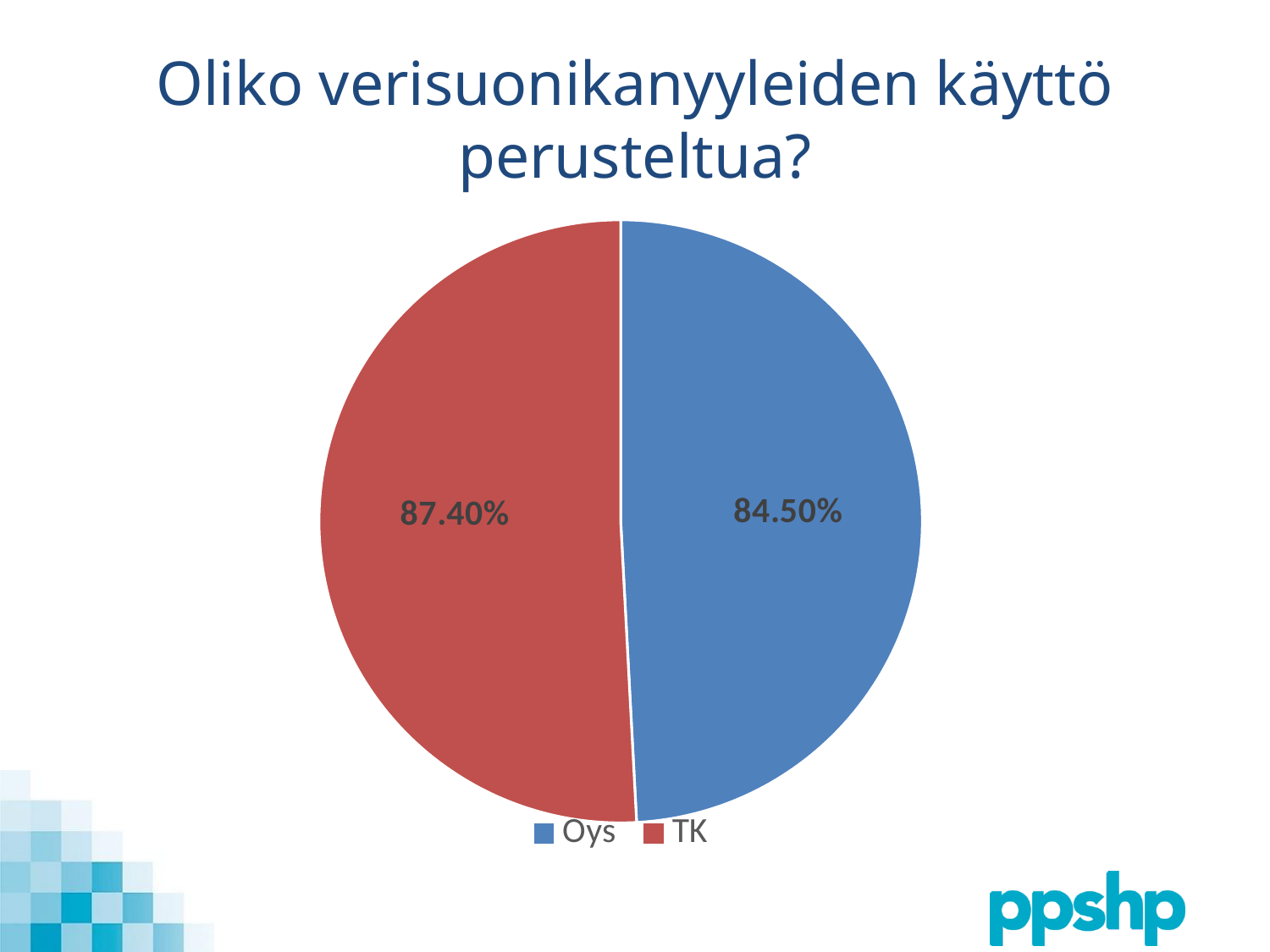
Which category has the highest value in the pie chart? TK What kind of chart is shown on the slide? Pie chart How many entries does the legend list? 2 What is the title of the slide above the chart? Oliko verisuonikanyyleiden käyttö perusteltua? What value is shown for Oys in the pie chart? 84.50% How many categories does the pie chart show? 2 What colour is the slice for TK? Red What is the difference between the values for TK and Oys? 2.90% What value is shown for TK in the pie chart? 87.40% Which category has the lowest value in the pie chart? Oys Which category has the higher value, Oys or TK? TK